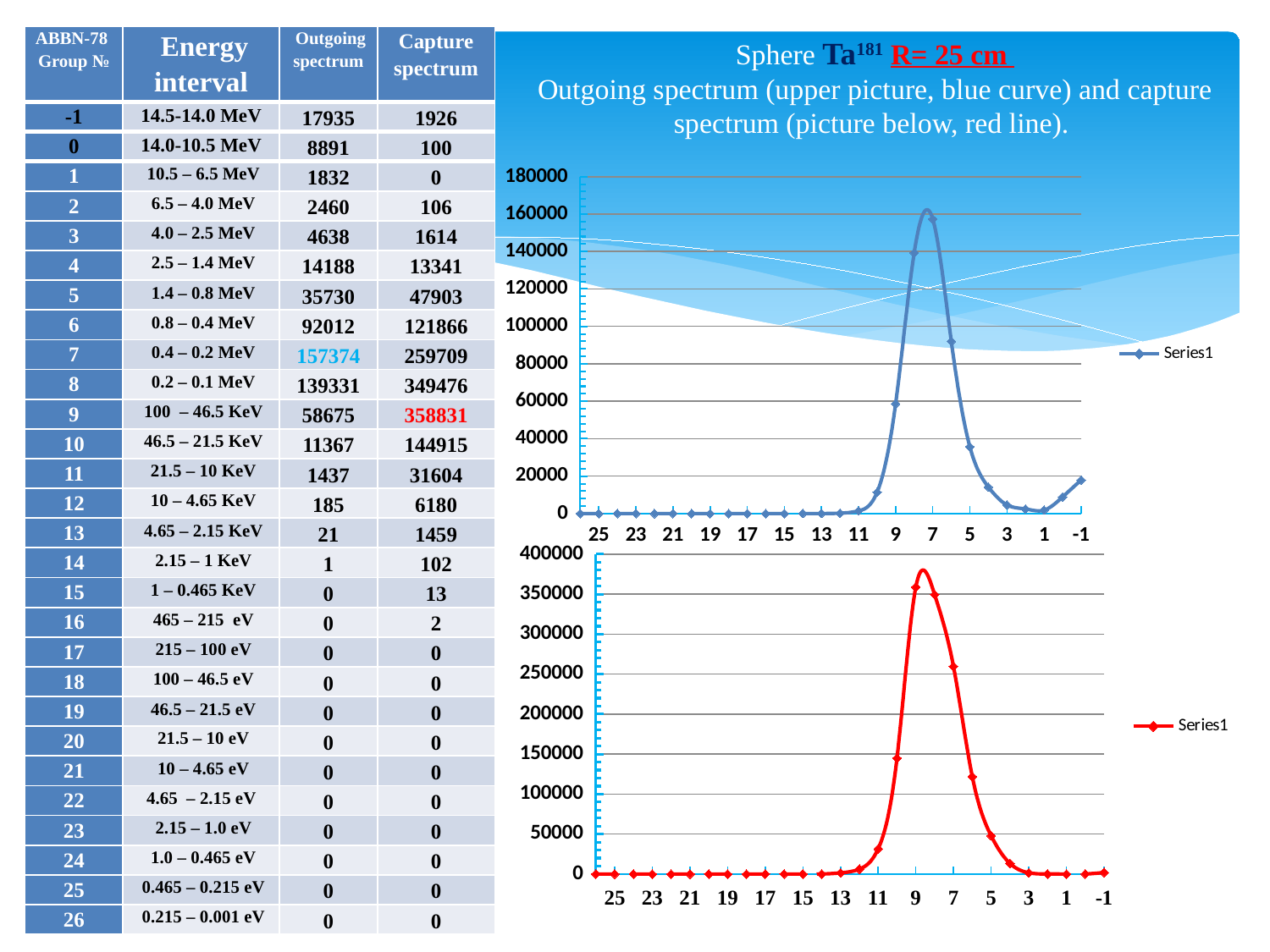
In the lower chart, is the value at group 7 greater or less than 300000? less In the lower chart, do the values rise or fall going from group 9 to group 5 along the x axis? fall What kind of chart is the upper chart on the slide? line chart In the lower chart, which has the larger value: group 9 or group 11? group 9 What kind of chart is the lower chart on the slide? line chart In the upper chart, is the value at group 9 greater or less than 40000? greater In the upper chart, at which x-axis group does the curve reach its highest value? 7 In the lower chart, at which x-axis group does the curve reach its highest value? 9 In the upper chart, what is the plotted value at group 25? 0 In the upper chart, is the value at group 7 greater or less than 140000? greater How many series does the legend of the lower chart list? 1